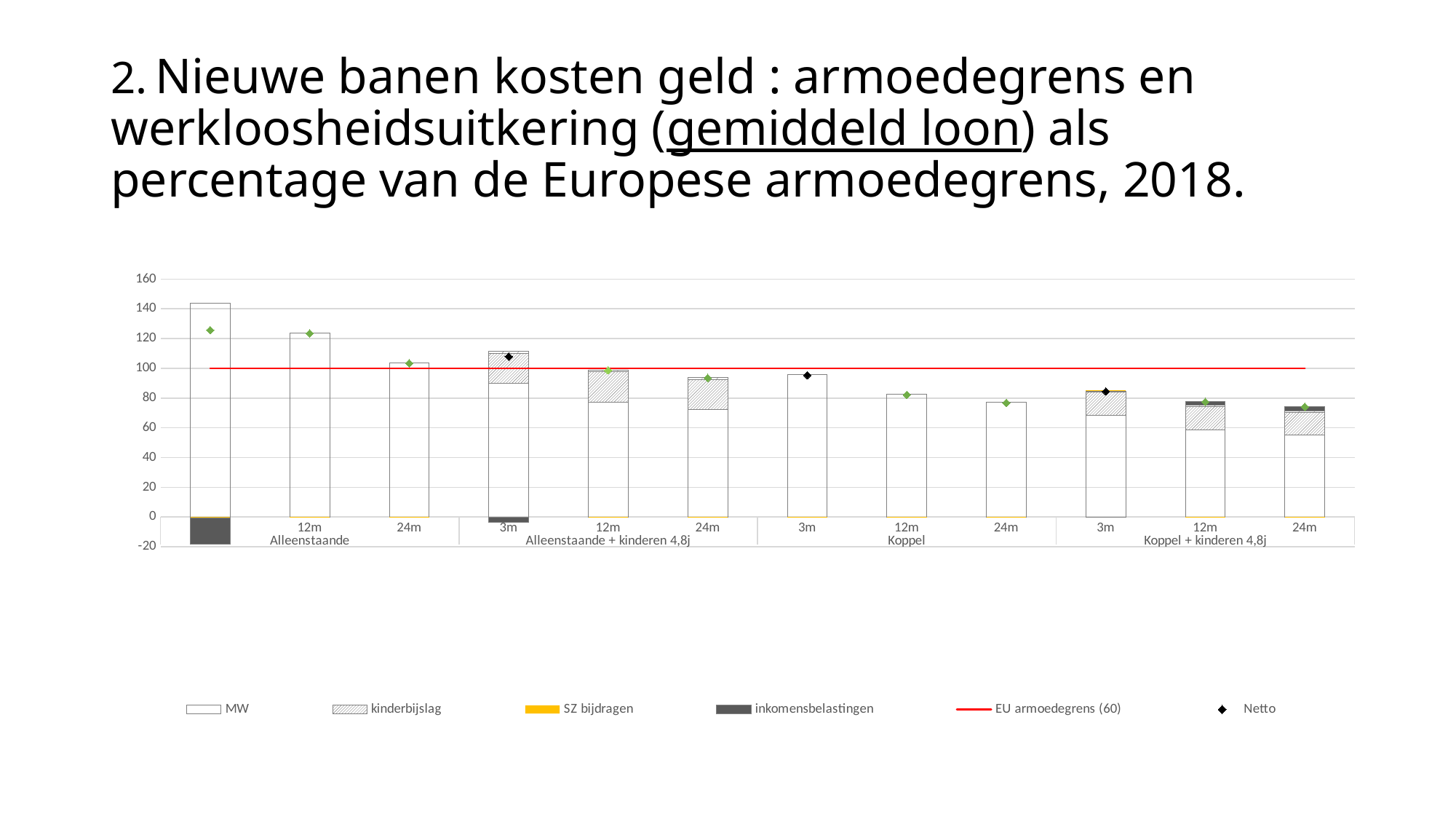
How many bars are plotted in the chart? 12 Is the Netto value for Koppel 3m greater or less than 100? less Is the Netto value for Koppel 24m greater or less than 80? less How many household groups are shown along the x axis? 4 Is the Netto value for Alleenstaande 12m greater or less than 100? greater Within the Alleenstaande group, do the Netto values rise or fall from 3m to 24m? fall What does the red horizontal line in the chart represent? EU armoedegrens (60) How many entries does the legend list? 6 Which bar has the highest Netto marker? Alleenstaande 3m What kind of chart is shown on the slide? Stacked bar chart with a line and markers Which has the larger Netto value: Alleenstaande 12m or Alleenstaande + kinderen 4,8j 12m? Alleenstaande 12m